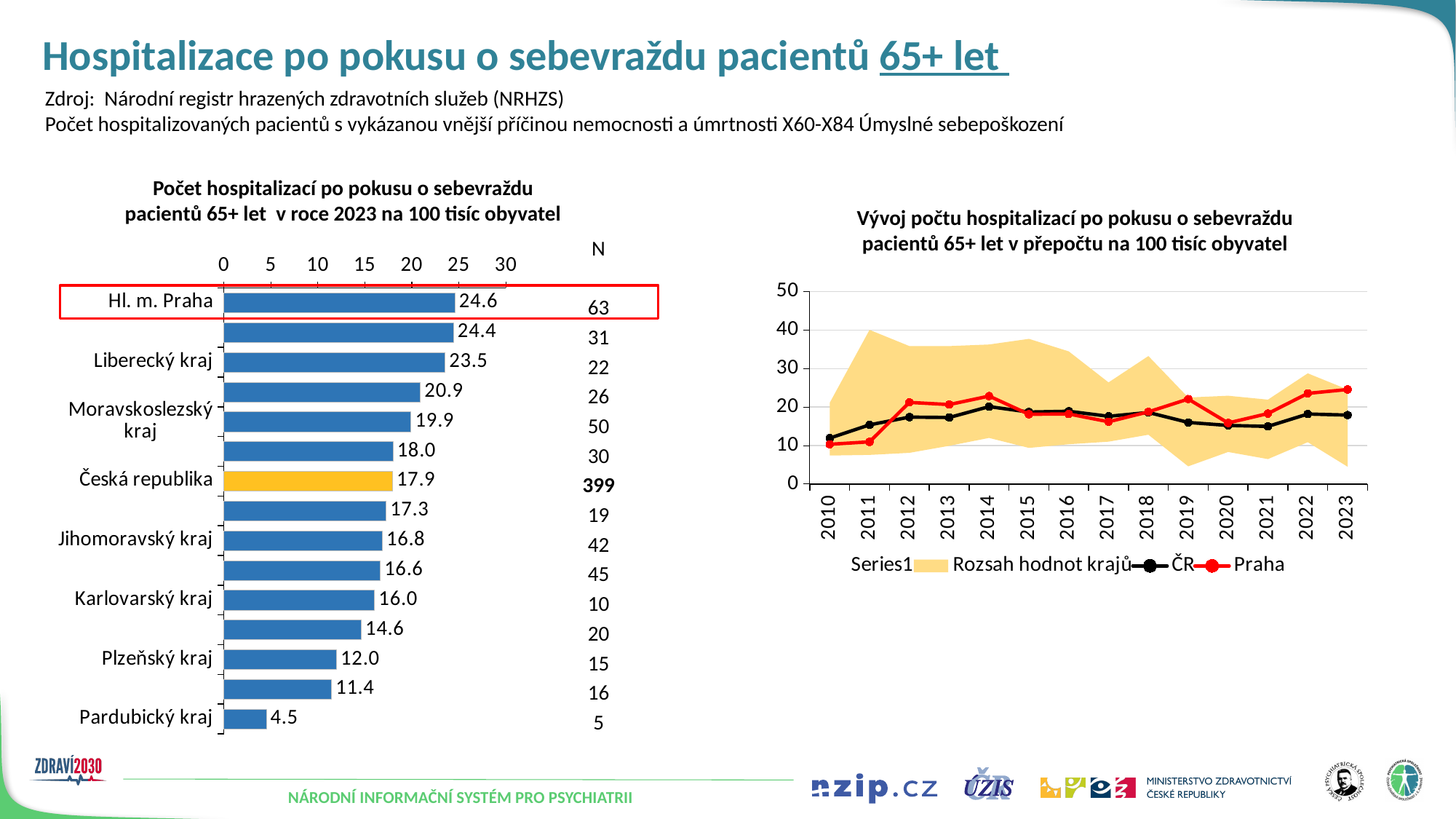
In the left bar chart, which category has the lowest value? Pardubický kraj In the left bar chart, what is the difference between the values for Hl. m. Praha and Česká republika? 6.7 In the left bar chart, how many bars are plotted? 15 In the right line chart, how many entries does the legend list? 4 In the right line chart, is the value for Praha in 2023 greater or less than 20? greater In the left bar chart, what is the value for Pardubický kraj? 4.5 In the left bar chart, what is the value for Česká republika? 17.9 What kind of chart is the chart on the left of the slide? Bar chart In the right line chart, which is larger in 2023, the value for Praha or the value for ČR? Praha In the left bar chart, which is larger, the value for Liberecký kraj or the value for Jihomoravský kraj? Liberecký kraj In the left bar chart, what is the value for Hl. m. Praha? 24.6 In the left bar chart, which category has the highest value? Hl. m. Praha